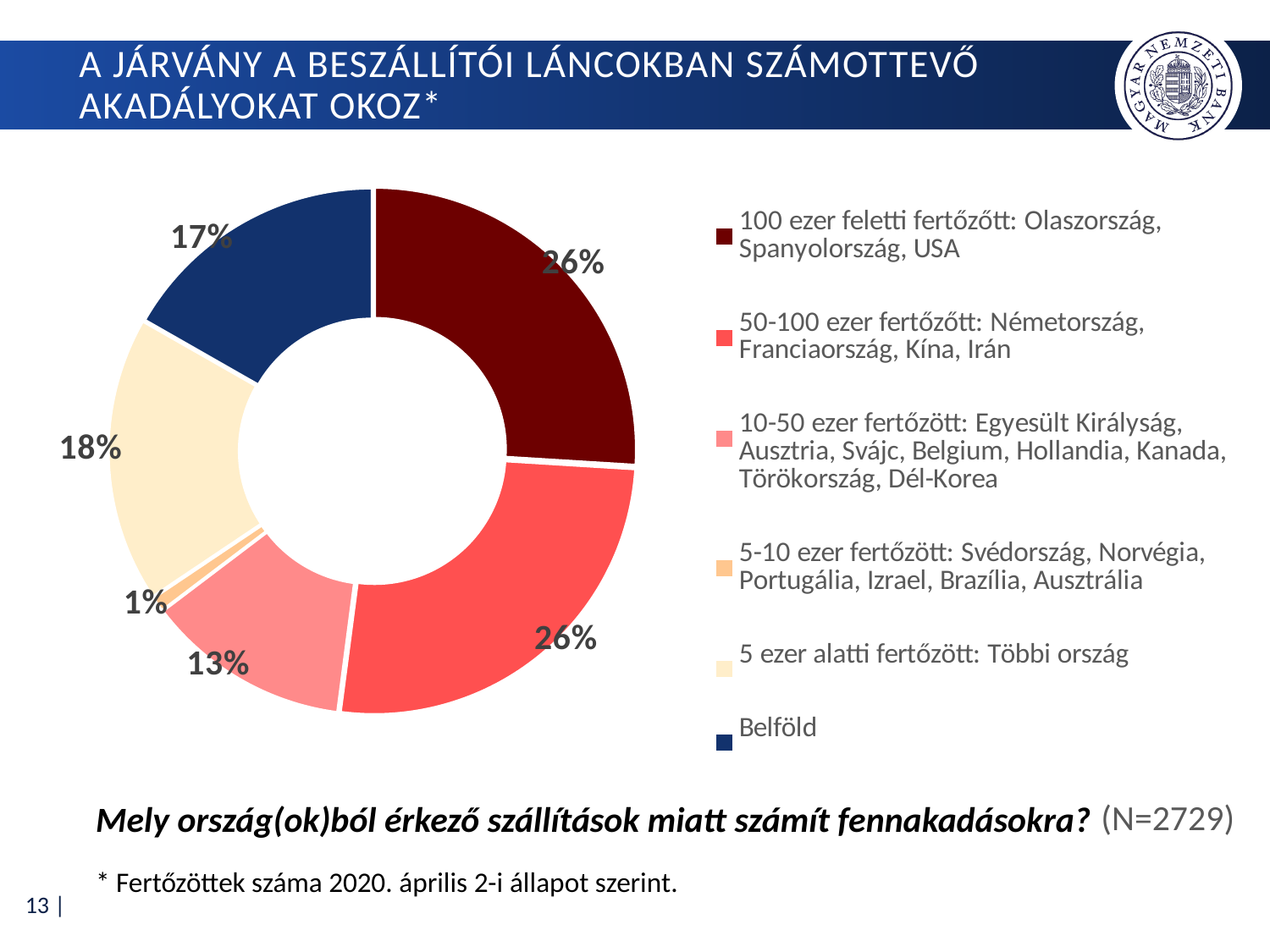
What colour is the 'Belföld' slice in the chart? Dark blue (navy) What is the difference between the '5 ezer alatti fertőzött' slice and the '10-50 ezer fertőzött' slice? 5 percentage points What kind of chart is shown on the slide? Pie chart (donut) What is the combined share of the '100 ezer feletti fertőzött' and '50-100 ezer fertőzött' slices? 52% What is the value shown for the '10-50 ezer fertőzött' slice? 13% Which is larger: the 'Belföld' slice or the '10-50 ezer fertőzött' slice? Belföld What is the value shown for the '5 ezer alatti fertőzött: Többi ország' slice? 18% What is the value shown for the '5-10 ezer fertőzött' slice? 1% What share of the pie does the 'Belföld' slice represent? 17% How many entries does the legend list? 6 Which category has the smallest slice of the pie? 5-10 ezer fertőzött: Svédország, Norvégia, Portugália, Izrael, Brazília, Ausztrália How many slices does the pie chart have? 6